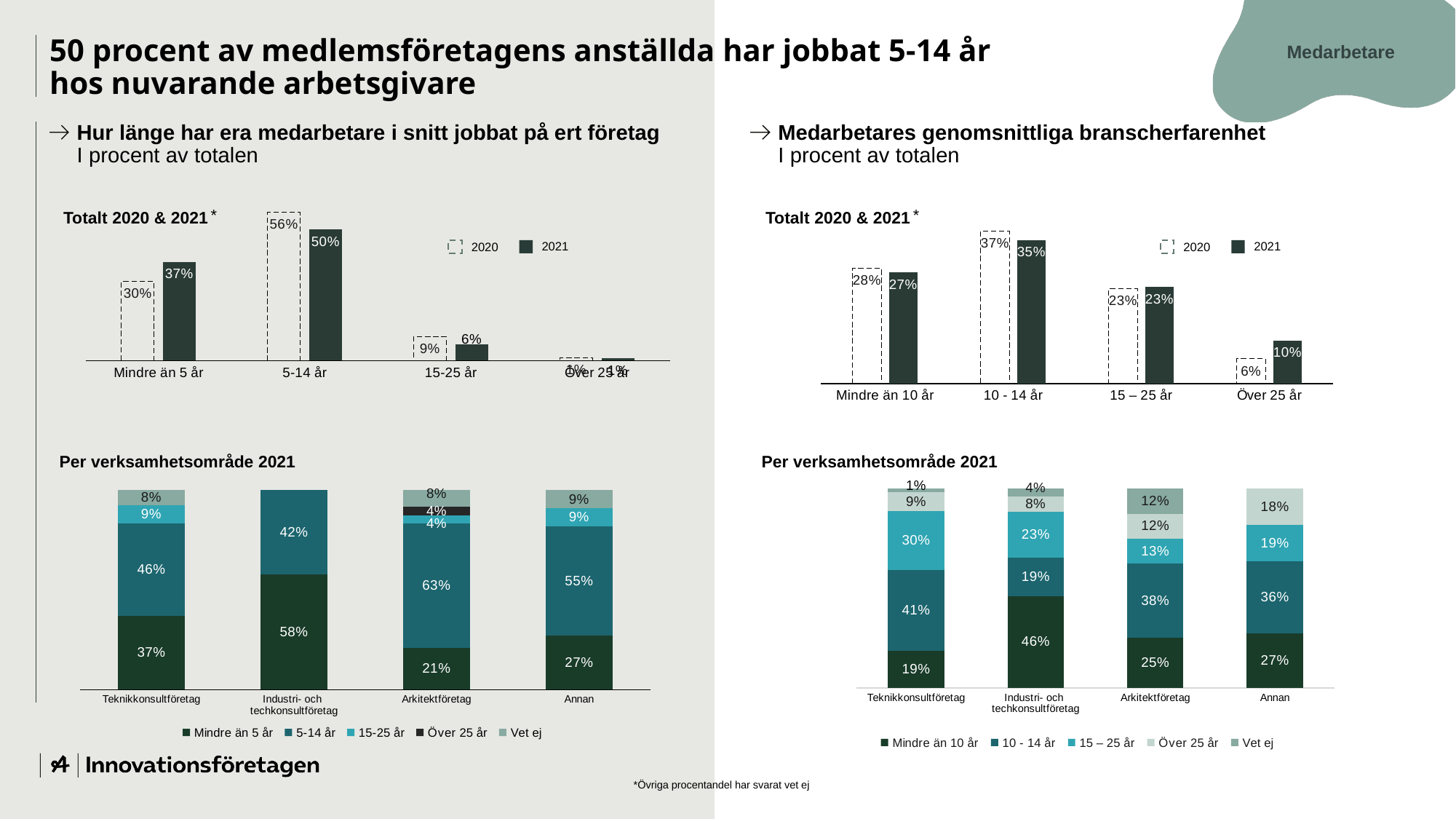
In the bottom-left chart (Per verksamhetsområde 2021, under Hur länge har era medarbetare i snitt jobbat), which category has the highest 5-14 år value? Arkitektföretag In the top-left chart (Totalt 2020 & 2021, Hur länge har era medarbetare i snitt jobbat), what is the difference between the 2020 and 2021 values for 5-14 år? 6% In the top-right chart (Medarbetares genomsnittliga branscherfarenhet, Totalt 2020 & 2021), what is the 2020 value for 10 - 14 år? 37% In the bottom-left chart (Per verksamhetsområde 2021, under Hur länge har era medarbetare i snitt jobbat), what is the Mindre än 5 år share for Industri- och techkonsultföretag? 58% In the top-right chart (Medarbetares genomsnittliga branscherfarenhet, Totalt 2020 & 2021), which category has the lowest 2021 value? Över 25 år In the top-left chart (Totalt 2020 & 2021, Hur länge har era medarbetare i snitt jobbat), which category has the highest 2021 value? 5-14 år What type of chart is the bottom-right chart (Per verksamhetsområde 2021, under Medarbetares genomsnittliga branscherfarenhet)? Stacked bar chart In the top-left chart (Hur länge har era medarbetare i snitt jobbat på ert företag, Totalt 2020 & 2021), what is the 2021 value for 5-14 år? 50% How many series does the legend of the top-right chart (Medarbetares genomsnittliga branscherfarenhet, Totalt 2020 & 2021) list? 2 In the top-left chart (Totalt 2020 & 2021, Hur länge har era medarbetare i snitt jobbat), what is the 2020 value for Mindre än 5 år? 30% In the bottom-right chart (Per verksamhetsområde 2021, under Medarbetares genomsnittliga branscherfarenhet), what is the 15 – 25 år share for Teknikkonsultföretag? 30% In the top-right chart (Medarbetares genomsnittliga branscherfarenhet, Totalt 2020 & 2021), is the 2020 value for Över 25 år larger or smaller than the 2021 value? smaller